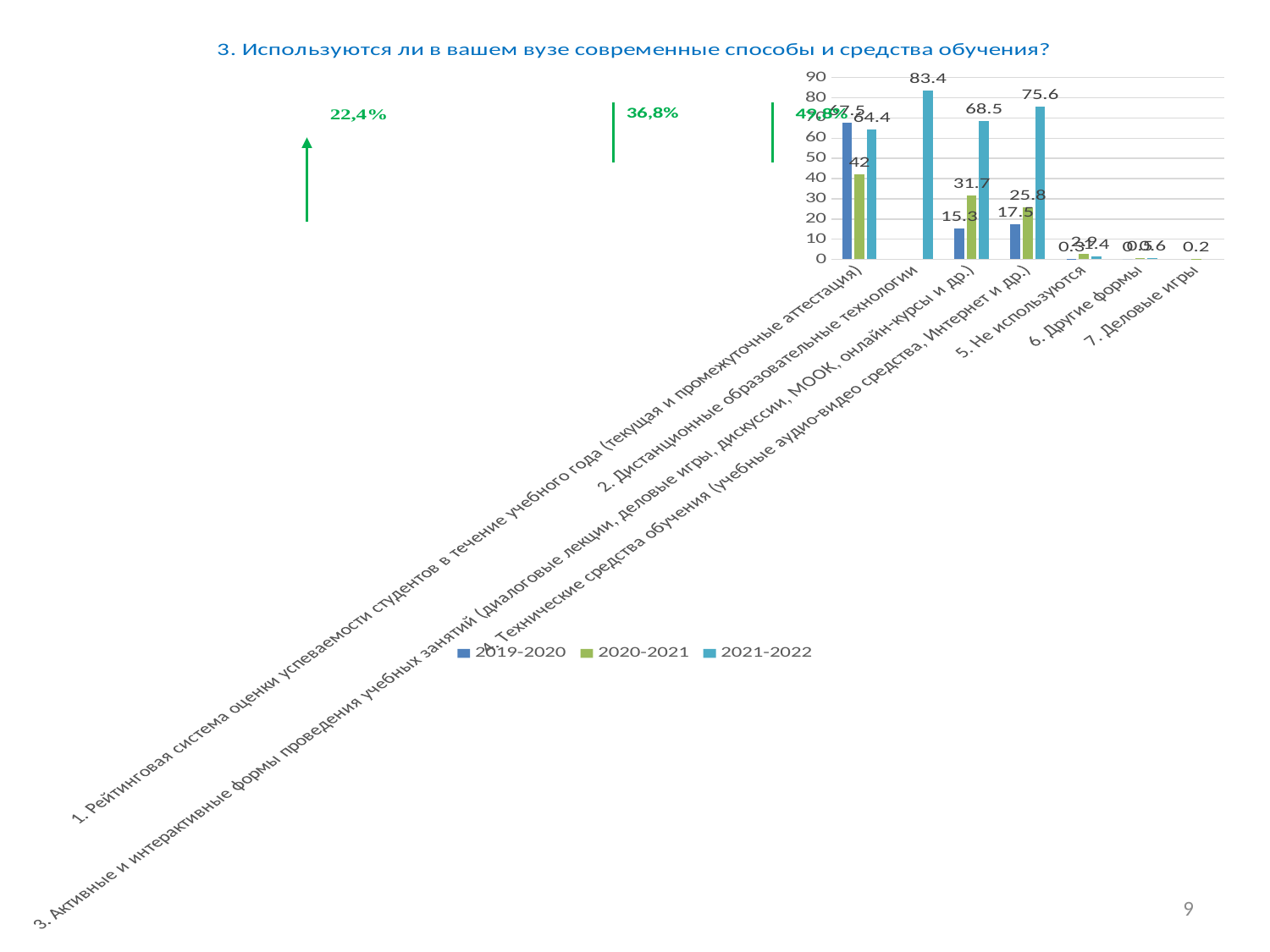
What is the value for "1. Рейтинговая система оценки успеваемости студентов" in the 2020-2021 series? 42 How many categories are shown on the x axis? 7 Which category has the highest value in the 2021-2022 series? 2. Дистанционные образовательные технологии Which is larger for "1. Рейтинговая система оценки успеваемости студентов": the 2019-2020 value or the 2021-2022 value? 2019-2020 What is the value for "3. Активные и интерактивные формы проведения учебных занятий" in the 2019-2020 series? 15.3 What is the value for "2. Дистанционные образовательные технологии" in the 2021-2022 series? 83.4 How many series does the legend list? 3 Do the values for "4. Технические средства обучения" rise or fall from 2019-2020 to 2021-2022? rise What kind of chart is shown on the slide? bar chart What is the value for "4. Технические средства обучения" in the 2021-2022 series? 75.6 What is the difference between the 2021-2022 and 2019-2020 values for "3. Активные и интерактивные формы проведения учебных занятий"? 53.2 What is the title of the chart? 3. Используются ли в вашем вузе современные способы и средства обучения?